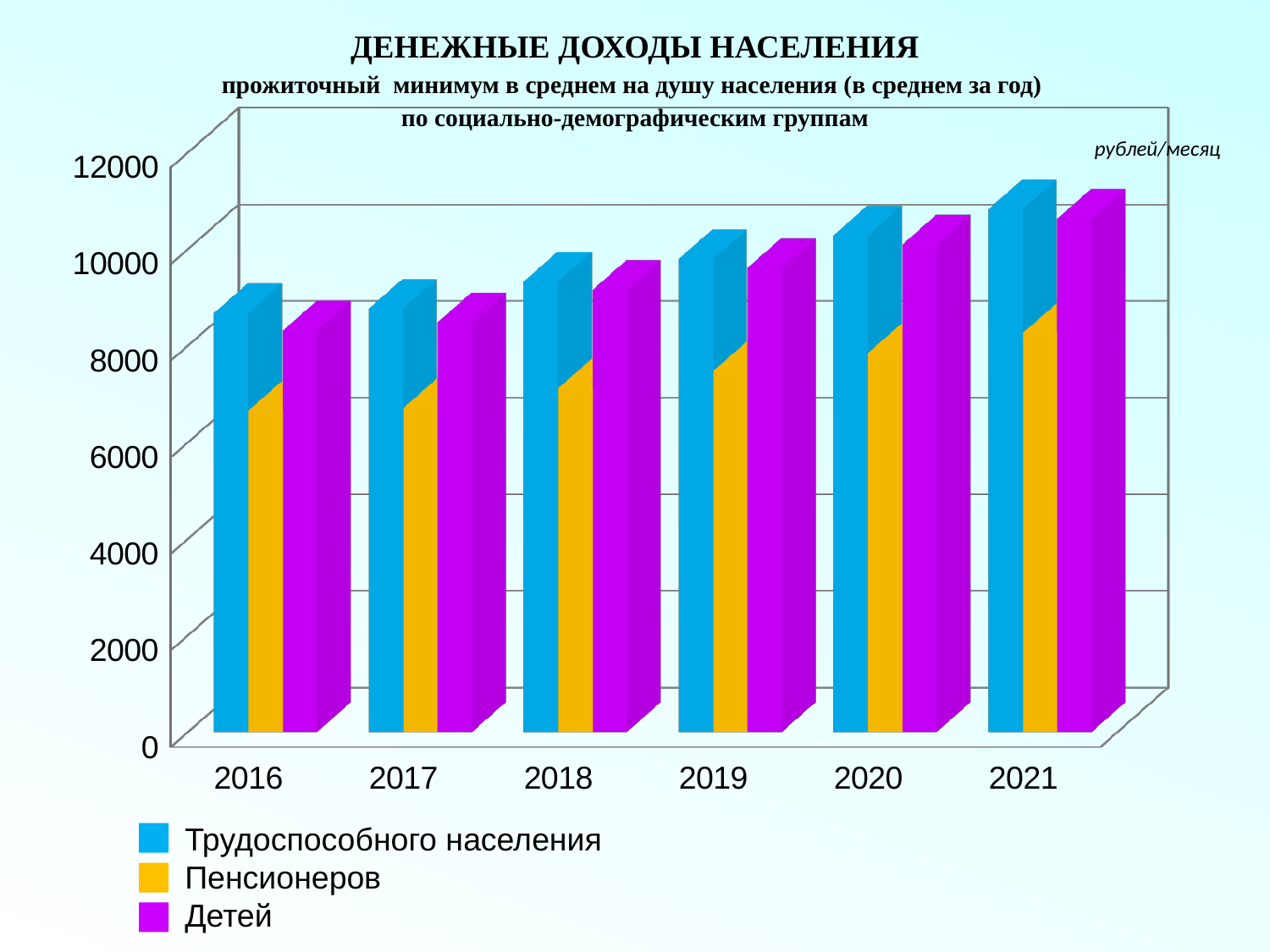
What kind of chart is shown on the slide? bar chart Is the value for Трудоспособного населения in 2021 greater or less than 10000? greater Is the value for Пенсионеров in 2016 greater or less than 8000? less How many series does the legend list? 3 Is the value for Трудоспособного населения in 2016 greater or less than 10000? less Do the values for Детей rise or fall from 2016 to 2021? rise What unit is indicated in the top right corner of the chart? рублей/месяц Which year has the lowest value for Пенсионеров? 2016 Which year has the highest value for Трудоспособного населения? 2021 In 2018, which is larger: the value for Трудоспособного населения or for Пенсионеров? Трудоспособного населения How many years are shown on the x axis of the chart? 6